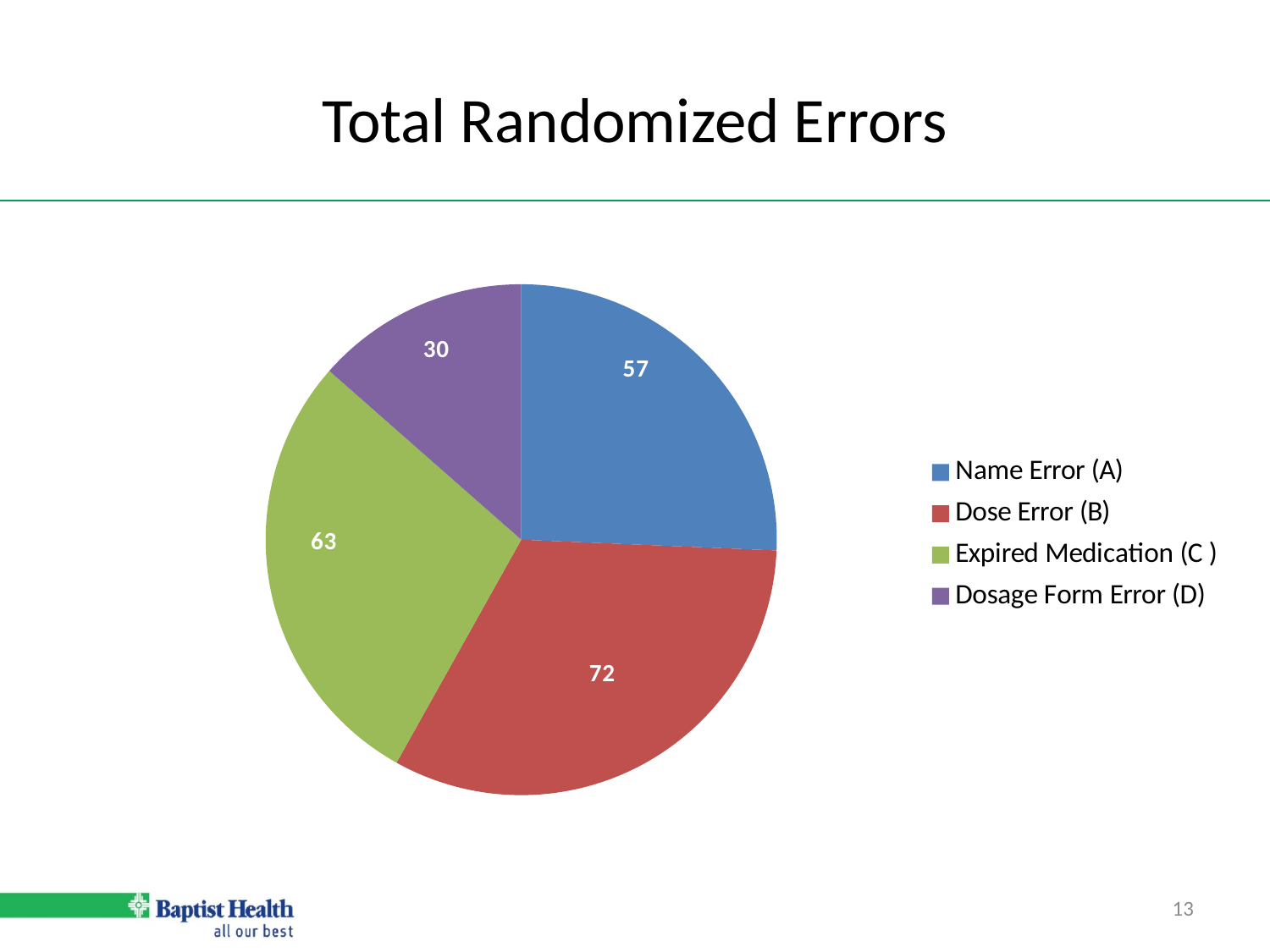
What is the difference between Dose Error (B) and Dosage Form Error (D)? 42 Which is larger, Expired Medication (C) or Name Error (A)? Expired Medication (C) What is the value for Dosage Form Error (D)? 30 What is the value for Dose Error (B)? 72 Which category has the smallest slice? Dosage Form Error (D) What is the title of the chart? Total Randomized Errors What is the value for Name Error (A)? 57 Which category has the largest slice? Dose Error (B) What kind of chart is shown on the slide? Pie chart How many categories are shown in the pie chart? 4 What is the total of all slices in the pie chart? 222 What is the value for Expired Medication (C)? 63